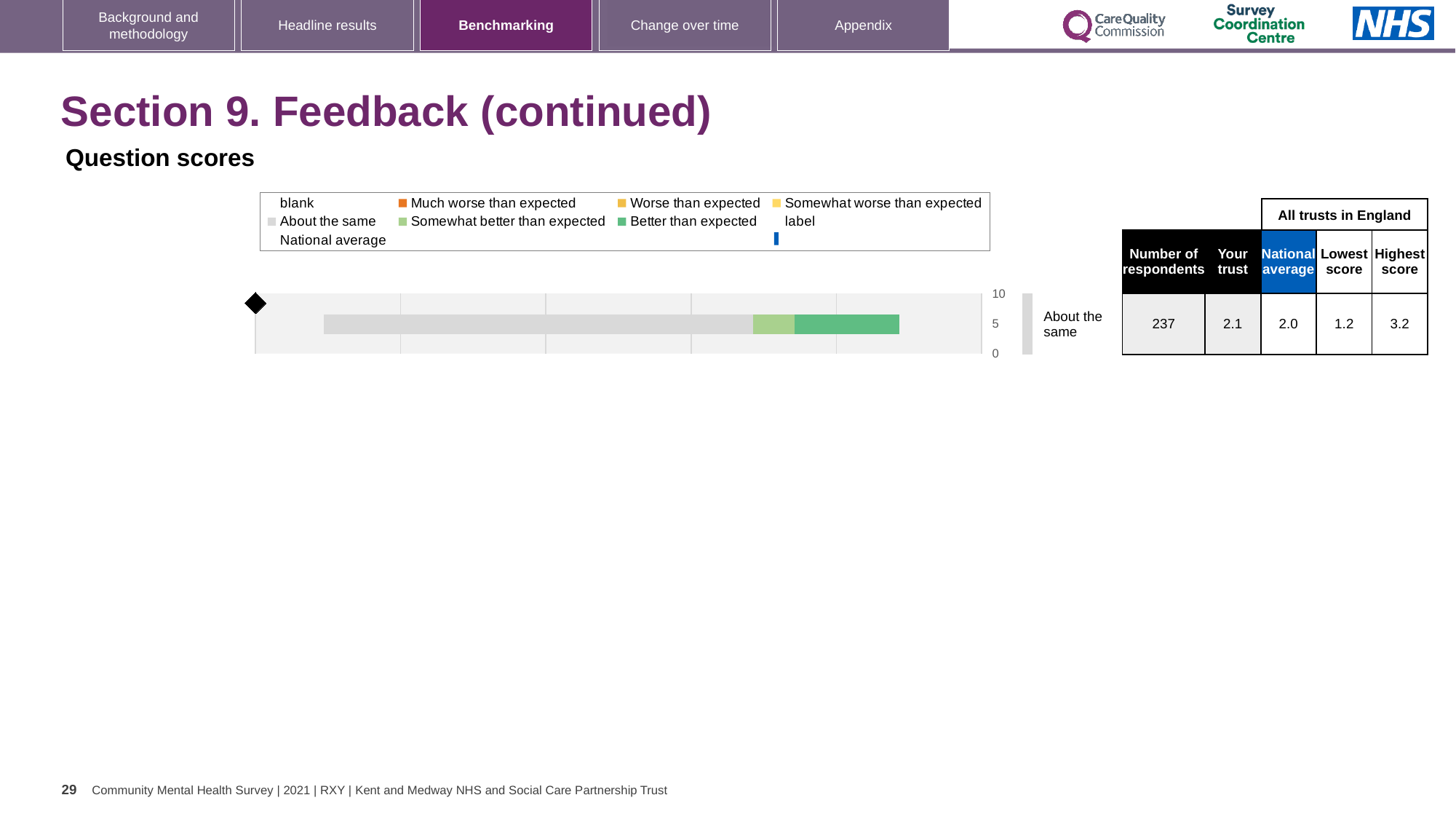
In the table beside the chart, what is the highest score among all trusts in England? 3.2 In the table beside the chart, what is the number of respondents for 'About the same'? 237 Which legend entry is shown in dark green in the chart? Better than expected What kind of chart is shown on the slide? bar chart In the table beside the chart, what is the difference between the highest score and the lowest score? 2.0 In the table beside the chart, what is the 'Your trust' score for 'About the same'? 2.1 What is the category label shown to the right of the bar in the chart? About the same In the table beside the chart, which is larger for 'About the same': the 'Your trust' score or the national average? Your trust What is the highest tick value shown on the chart's axis? 10 In the table beside the chart, what is the national average score for 'About the same'? 2.0 How many bars are plotted in the chart? 1 How many entries does the chart's legend list? 9